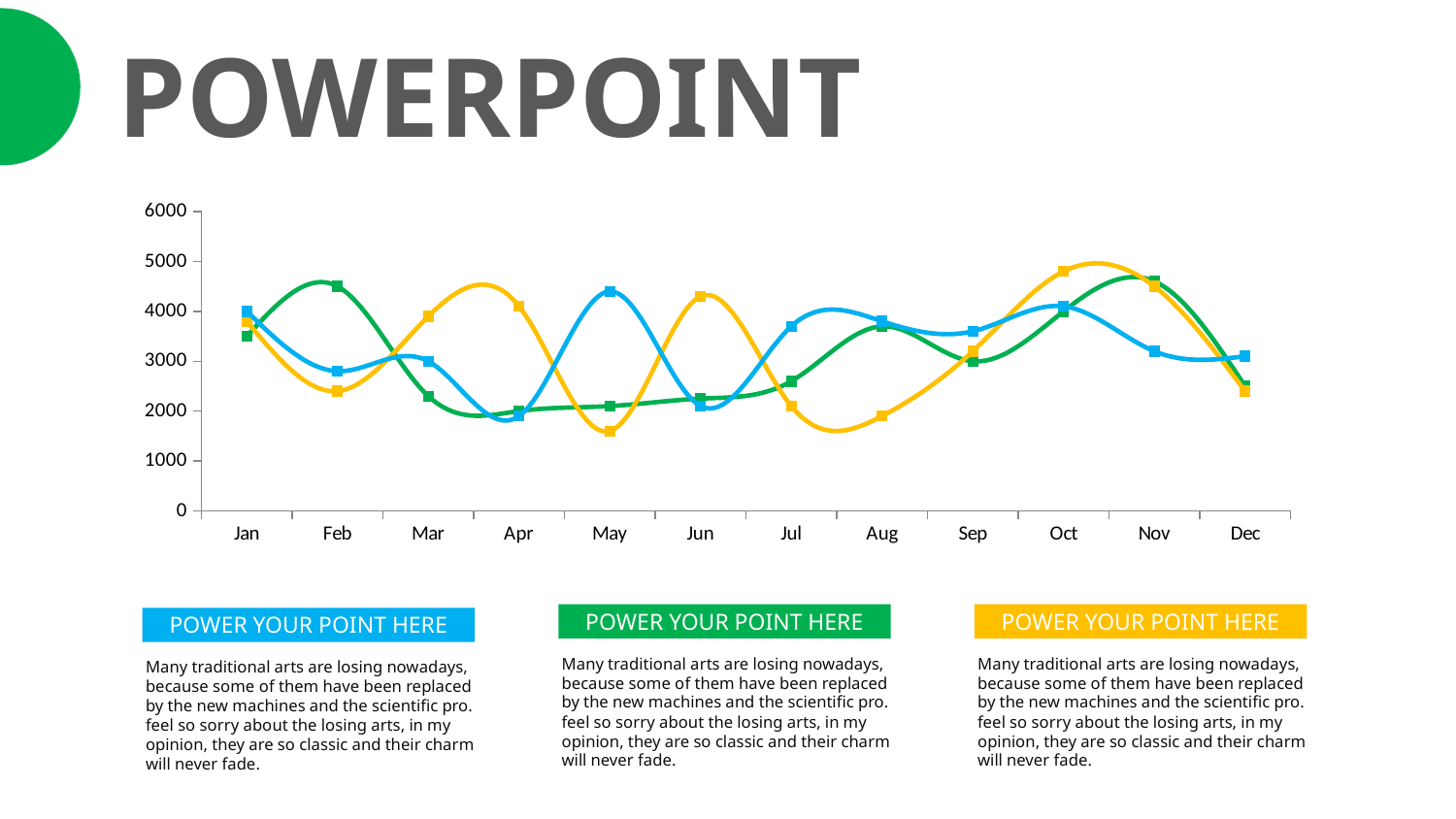
What kind of chart is shown on the slide? line chart Is the value of the blue line in May greater or less than 4000? greater Is the value of the yellow line in Oct greater or less than 4000? greater In which month does the yellow line reach its highest value? Oct Is the value of the green line in Apr greater or less than 3000? less In which month does the yellow line reach its lowest value? May How many lines (series) are plotted on the chart? 3 What is the highest value shown on the y axis of the chart? 6000 How many categories are shown on the x axis of the chart? 12 In Feb, which line has the higher value, the green line or the yellow line? green line